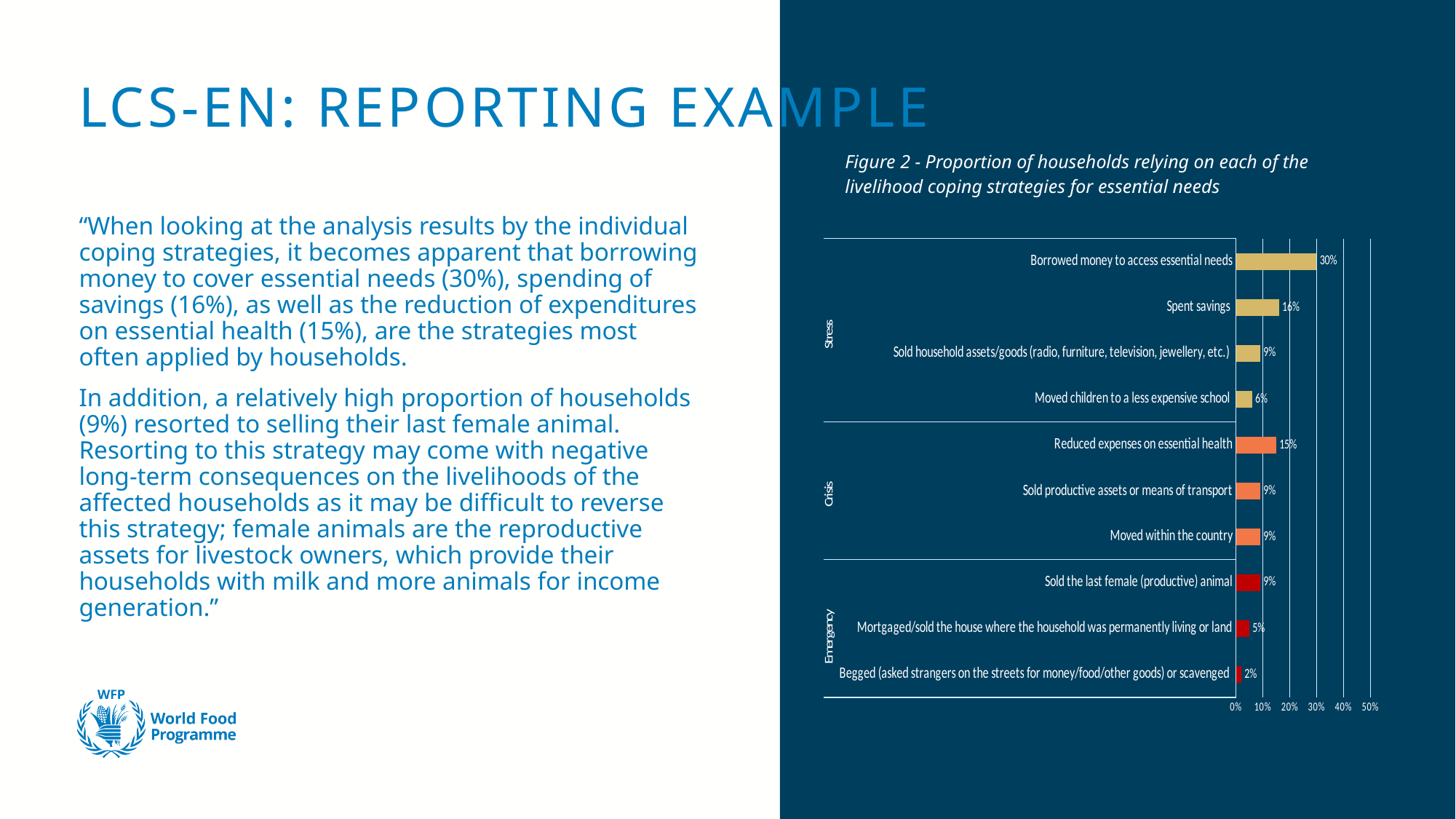
What is the difference between the proportion of households that borrowed money to access essential needs and those that spent savings? 14% Into which three groups are the coping strategies categorised on the chart's vertical axis? Stress, Crisis, Emergency Which coping strategy has the highest proportion of households? Borrowed money to access essential needs What proportion of households borrowed money to access essential needs? 30% Which coping strategy has the lowest proportion of households? Begged (asked strangers on the streets for money/food/other goods) or scavenged What proportion of households reduced expenses on essential health? 15% What is the title of the figure on the slide? Figure 2 - Proportion of households relying on each of the livelihood coping strategies for essential needs What proportion of households spent savings? 16% Which is larger: the proportion of households that moved children to a less expensive school or those that mortgaged/sold their house or land? Moved children to a less expensive school How many coping strategies are shown in the chart? 10 What type of chart is shown on the slide? Bar chart What proportion of households begged or scavenged? 2%